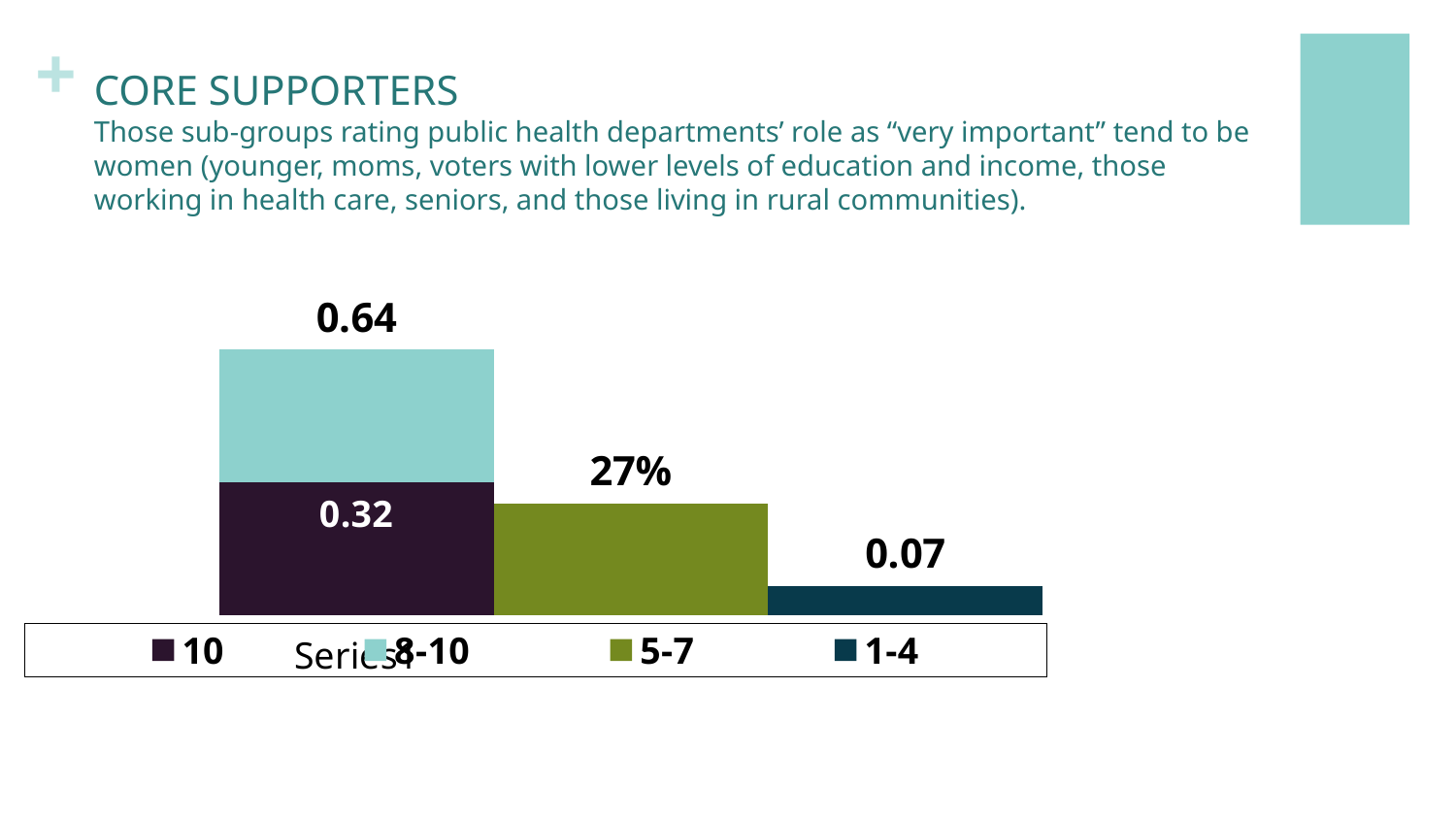
What colour is the 5-7 series in the chart? green What value is printed on the dark segment for the 10 series? 0.32 What is the difference between the value labeled on the 10 segment (0.32) and the value for 1-4 (0.07)? 0.25 What kind of chart is shown on the slide? bar chart Which has the larger labeled value, 5-7 or 1-4? 5-7 Which legend entry has the lowest labeled value? 1-4 What value is labeled on the 5-7 bar? 27% What value is labeled on the 1-4 bar? 0.07 What value is printed above the stacked bar containing the 10 and 8-10 segments? 0.64